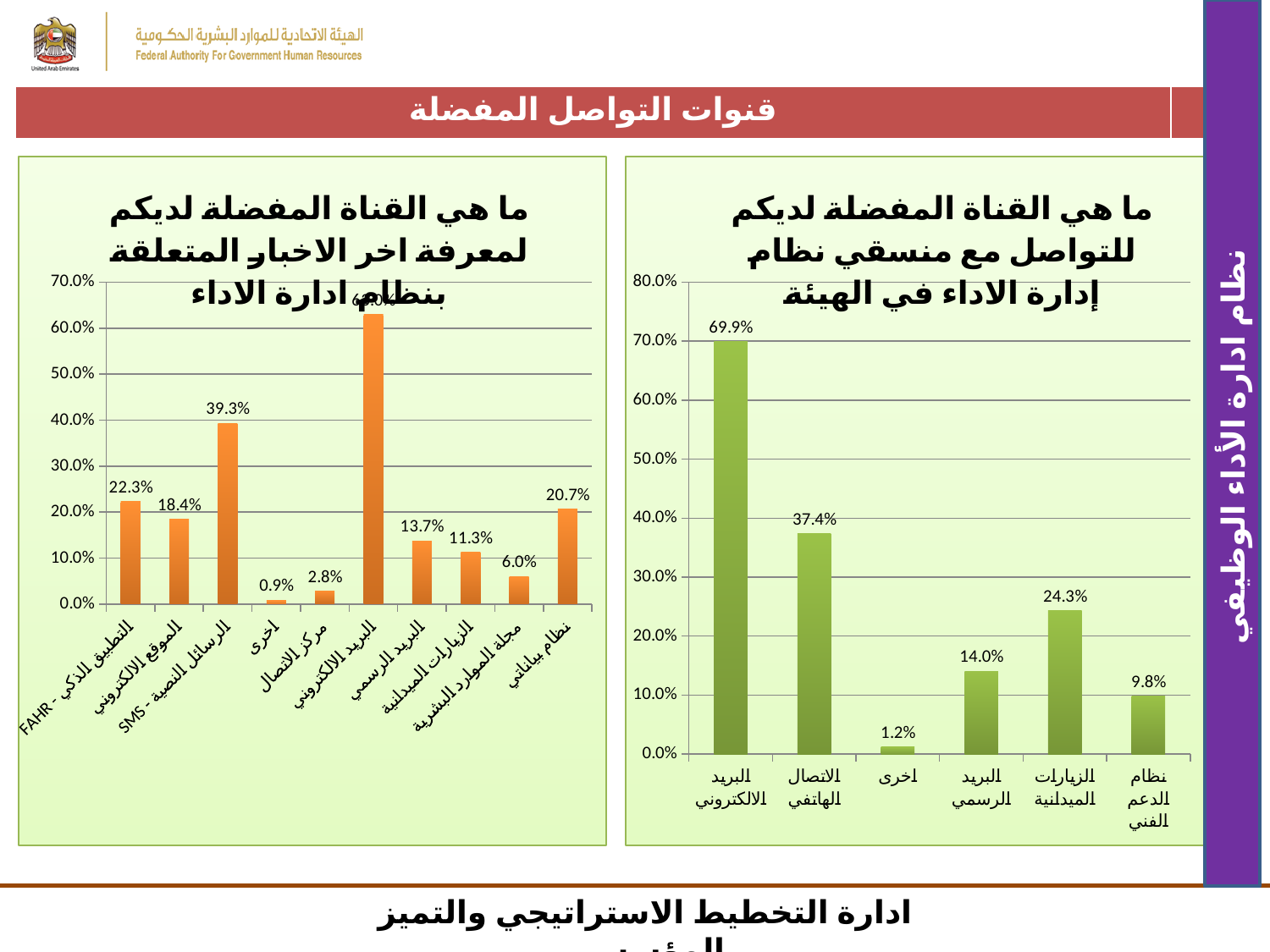
In the right chart, what is the value for الزيارات الميدانية? 24.3% In the left chart, what is the value for نظام بياناتي? 20.7% In the right chart, what is the difference between البريد الالكتروني and الاتصال الهاتفي? 32.5% In the left chart, how many categories are shown? 10 In the left chart, is the value for البريد الالكتروني greater or less than 60%? greater In the left chart, what is the value for الرسائل النصية - SMS? 39.3% What type of chart is the right chart? bar chart In the right chart, which category has the lowest value? اخرى In the left chart, which category has the highest value? البريد الالكتروني In the right chart, what is the value for البريد الالكتروني? 69.9% In the right chart, how many categories are shown? 6 In the right chart, which is larger: البريد الرسمي or نظام الدعم الفني? البريد الرسمي